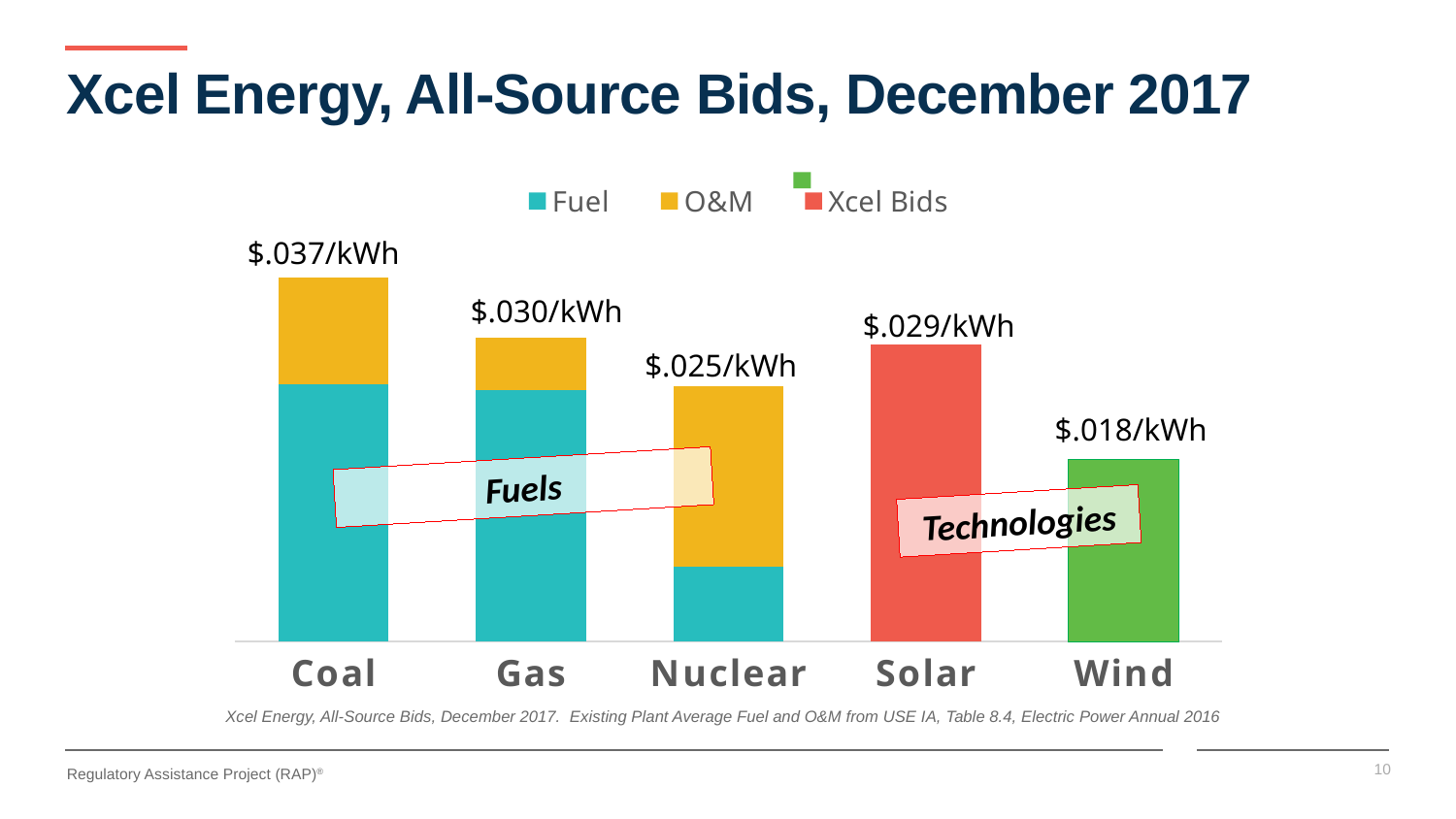
What is the labeled value for Gas? $.030/kWh What is the difference between the labeled values for Coal and Wind? $.019/kWh What is the labeled value for Coal? $.037/kWh What kind of chart is shown on the slide? Stacked bar chart How many series does the legend list? 3 What is the labeled value for Nuclear? $.025/kWh Which category has the lowest labeled value? Wind Which category has the highest labeled value? Coal What is the labeled value for Wind? $.018/kWh What is the labeled value for Solar? $.029/kWh Which has a larger labeled value, Gas or Solar? Gas How many categories are shown on the x axis? 5